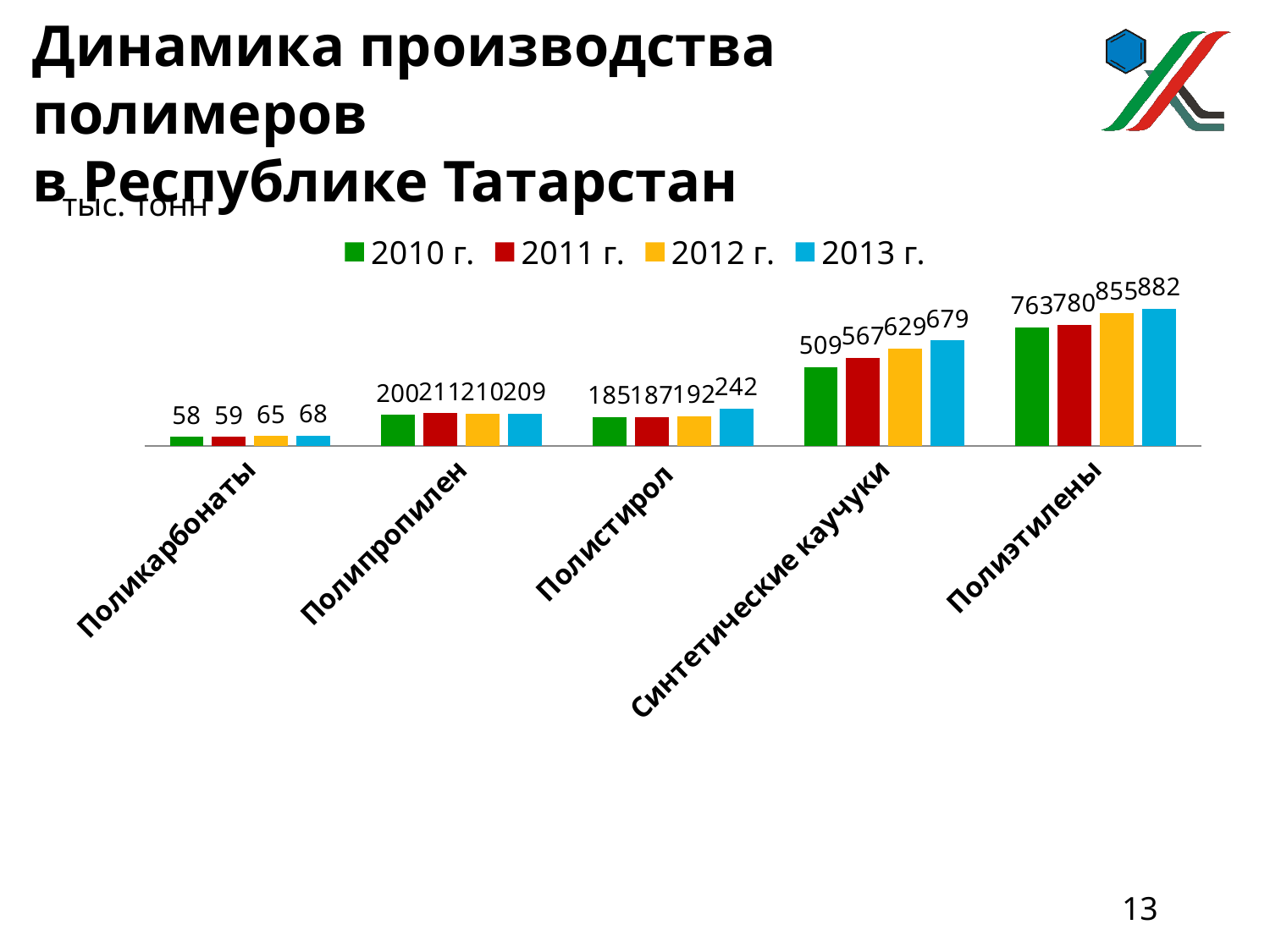
What unit is indicated above the chart? тыс. тонн How many series does the legend list? 4 Which category has the lowest value in 2010 г.? Поликарбонаты What kind of chart is shown on the slide? bar chart What is the value for Полистирол in 2013 г.? 242 What is the value for Полиэтилены in 2013 г.? 882 What is the value for Поликарбонаты in 2012 г.? 65 What is the difference between the 2013 г. and 2010 г. values for Синтетические каучуки? 170 What is the value for Синтетические каучуки in 2010 г.? 509 Which is larger: the 2011 г. value for Полипропилен or the 2011 г. value for Полистирол? Полипропилен How many categories are shown on the x axis? 5 Which category has the highest value in 2013 г.? Полиэтилены